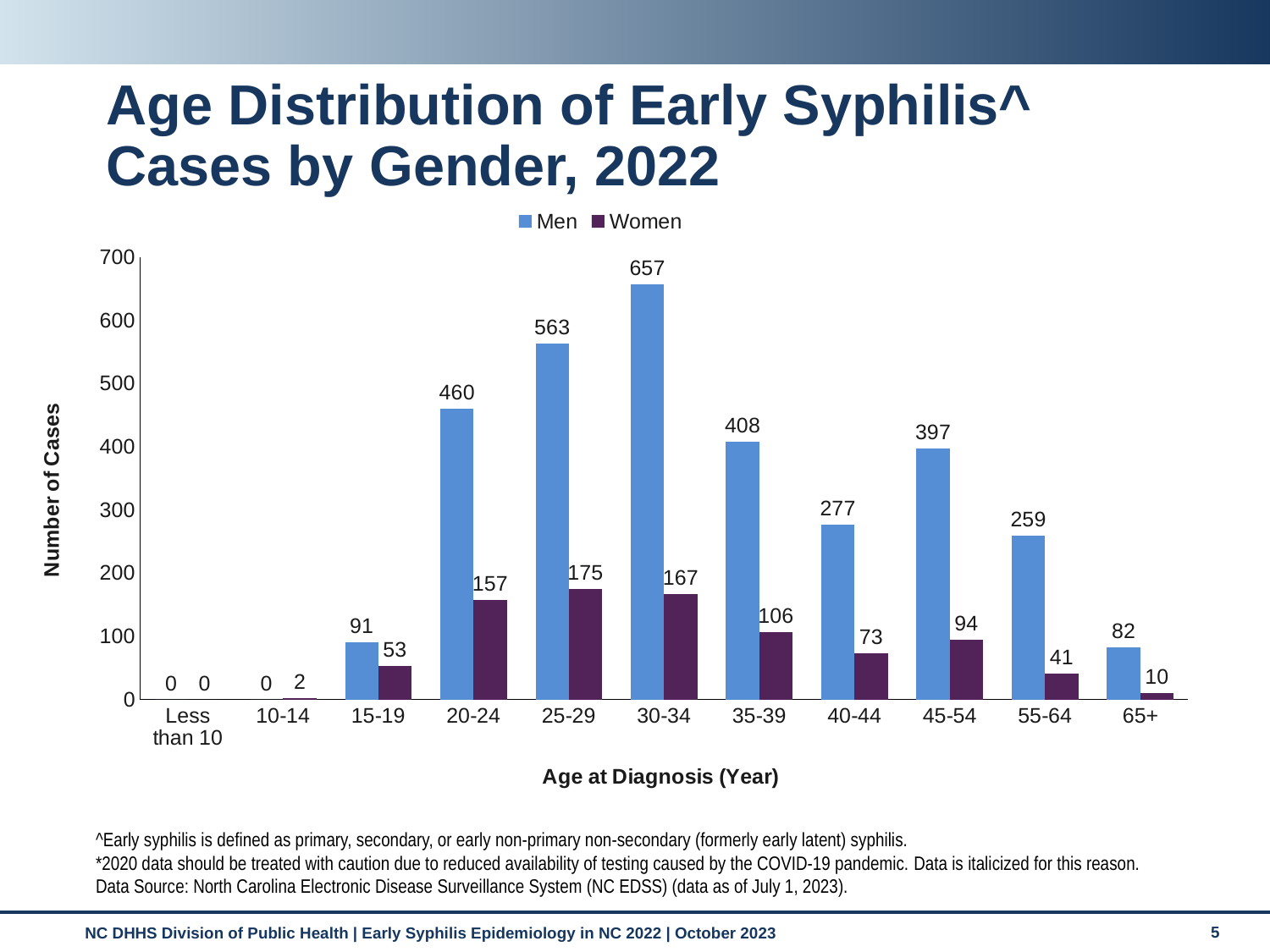
How many cases were reported among women aged 10-14? 2 What is the total number of cases (men plus women) in the 65+ age group? 92 What kind of chart is shown on the slide? Bar chart What is the label of the y axis? Number of Cases What is the difference between the number of cases for men and women in the 20-24 age group? 303 How many early syphilis cases were reported among women aged 25-29? 175 Which is larger, the number of cases for men aged 35-39 or men aged 45-54? Men aged 35-39 Which age group has the highest number of cases among women? 25-29 How many age groups are shown on the x axis? 11 Which age group has the highest number of cases among men? 30-34 How many series does the legend list? 2 How many early syphilis cases were reported among men aged 30-34? 657